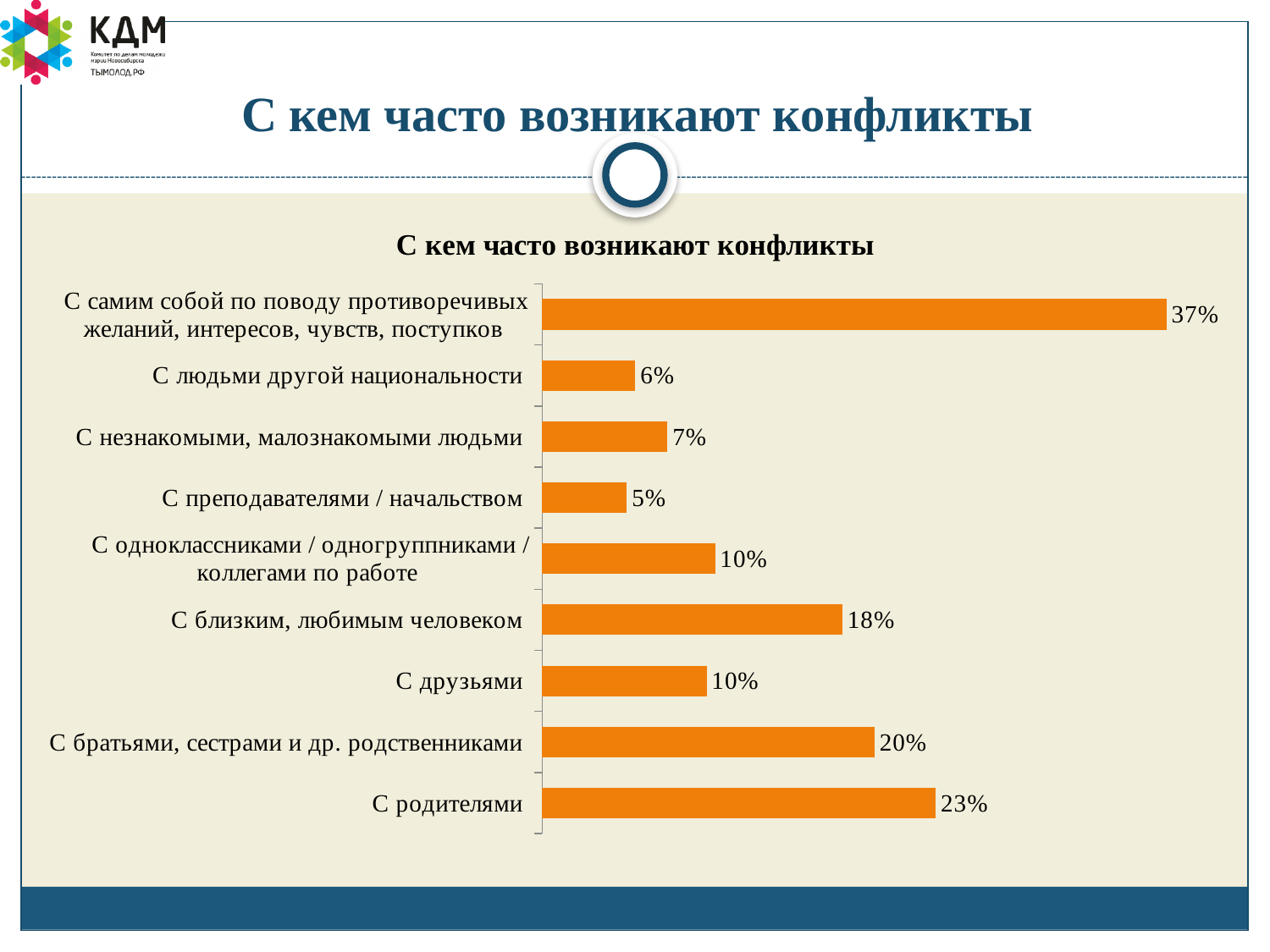
What is the value for «С близким, любимым человеком»? 18% What is the value for «С родителями»? 23% How many categories are shown in the chart? 9 What is the value for «С преподавателями / начальством»? 5% What is the difference between the values for «С родителями» and «С друзьями»? 13% What kind of chart is shown on the slide? Bar chart What is the title of the chart? С кем часто возникают конфликты Which category has the highest value? С самим собой по поводу противоречивых желаний, интересов, чувств, поступков What colour are the bars in the chart? Orange Which category has the lowest value? С преподавателями / начальством Which is larger: the value for «С незнакомыми, малознакомыми людьми» or for «С людьми другой национальности»? С незнакомыми, малознакомыми людьми What is the value for «С братьями, сестрами и др. родственниками»? 20%